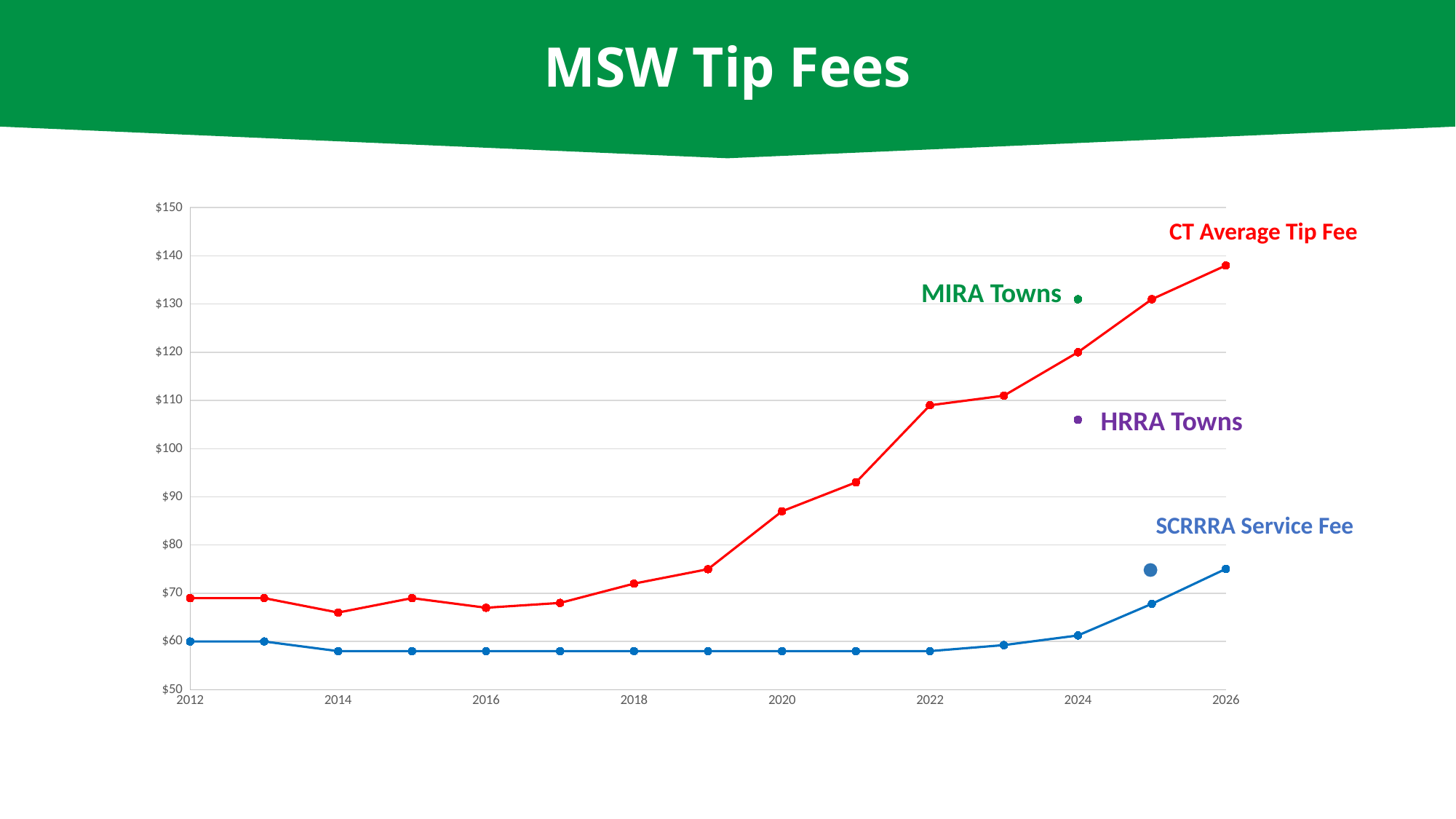
What colour is the CT Average Tip Fee line? red Is the SCRRRA Service Fee for 2026 greater or less than $80? less Is the CT Average Tip Fee for 2022 greater or less than $100? greater Is the MIRA Towns value greater or less than $120? greater Does the CT Average Tip Fee rise or fall from 2018 to 2026? rise Which is higher in 2026, the CT Average Tip Fee or the SCRRRA Service Fee? CT Average Tip Fee What kind of chart is shown on the slide? line chart What is the title of the slide? MSW Tip Fees Which is higher, the MIRA Towns point or the HRRA Towns point? MIRA Towns